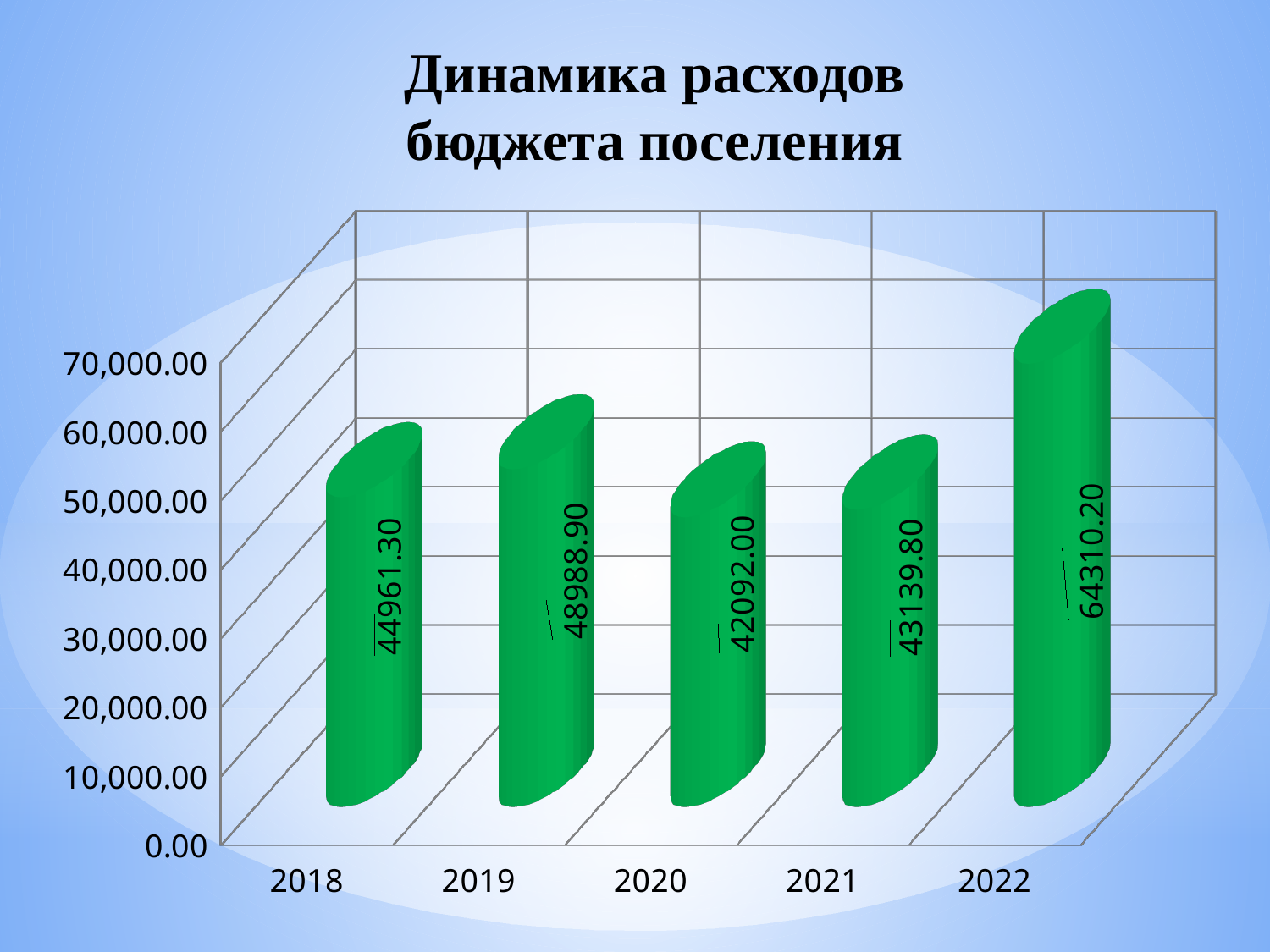
What kind of chart is this? bar chart What is the title of the chart? Динамика расходов бюджета поселения What is the value for 2020? 42092.00 Which year has the highest value? 2022 Is the value for 2022 greater or less than 60,000.00? greater Which is larger, the value for 2019 or the value for 2021? 2019 What is the difference between the values for 2019 and 2018? 4027.60 What is the value for 2018? 44961.30 Which year has the lowest value? 2020 What is the value for 2022? 64310.20 How many years are shown on the x axis? 5 What is the difference between the values for 2022 and 2021? 21170.40